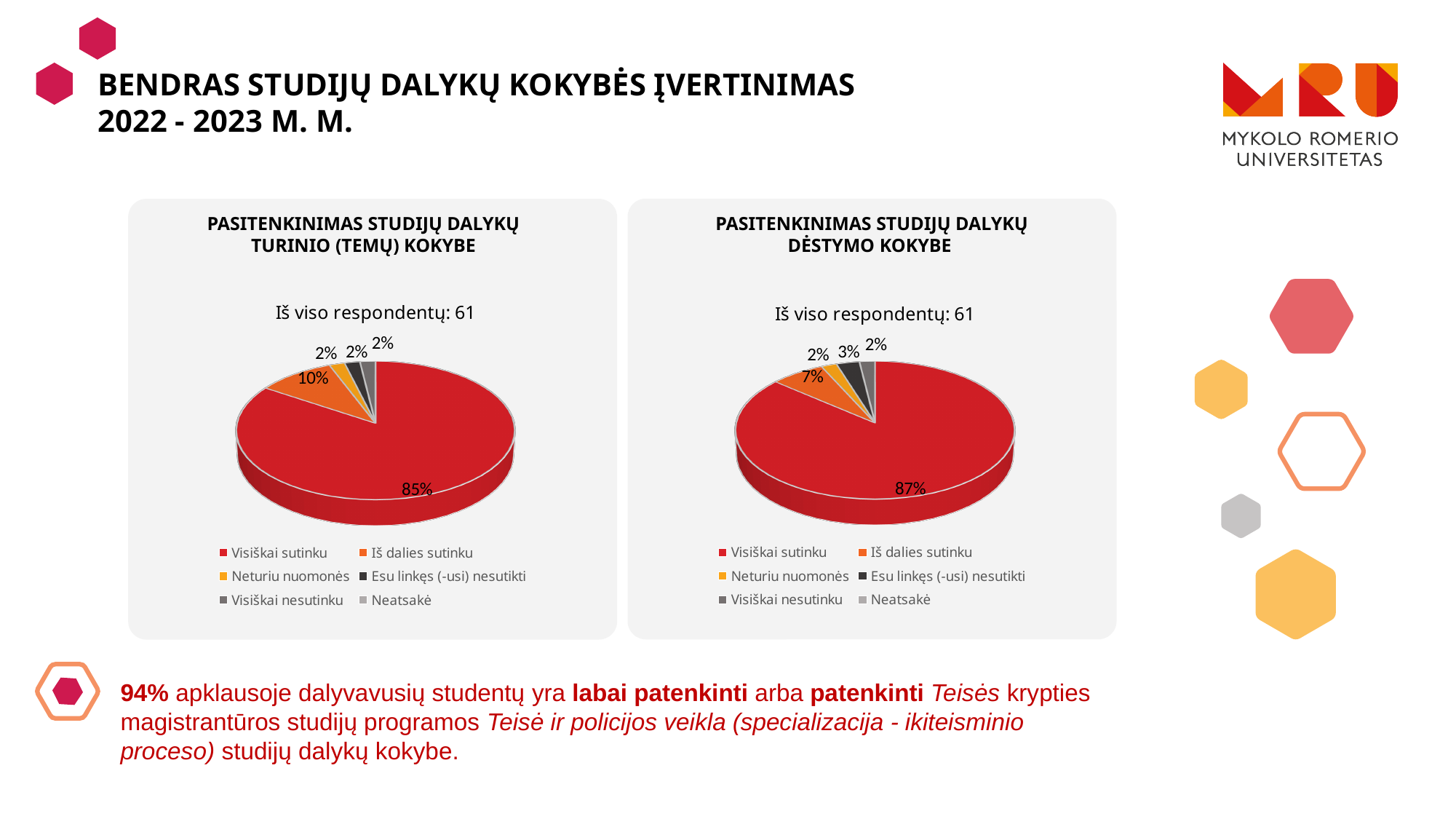
In the left chart (Pasitenkinimas studijų dalykų turinio (temų) kokybe), which category has the largest slice? Visiškai sutinku In the right chart (Pasitenkinimas studijų dalykų dėstymo kokybe), what share of respondents answered "Esu linkęs (-usi) nesutikti"? 3% In the right chart (Pasitenkinimas studijų dalykų dėstymo kokybe), what share of respondents answered "Visiškai sutinku"? 87% How many respondents in total are reported for the right chart (Pasitenkinimas studijų dalykų dėstymo kokybe)? 61 Which chart has the larger "Iš dalies sutinku" share, the left chart (turinio kokybe) or the right chart (dėstymo kokybe)? The left chart (turinio kokybe) In the left chart (Pasitenkinimas studijų dalykų turinio (temų) kokybe), what share of respondents answered "Visiškai sutinku"? 85% In the right chart (Pasitenkinimas studijų dalykų dėstymo kokybe), what share of respondents answered "Iš dalies sutinku"? 7% How many entries does the legend of the left chart list? 6 In the left chart (Pasitenkinimas studijų dalykų turinio (temų) kokybe), what share of respondents answered "Iš dalies sutinku"? 10% What is the difference between the "Visiškai sutinku" share in the right chart (87%) and in the left chart (85%)? 2% In the right chart (Pasitenkinimas studijų dalykų dėstymo kokybe), which category has the largest slice? Visiškai sutinku What type of chart is used on this slide? Pie chart